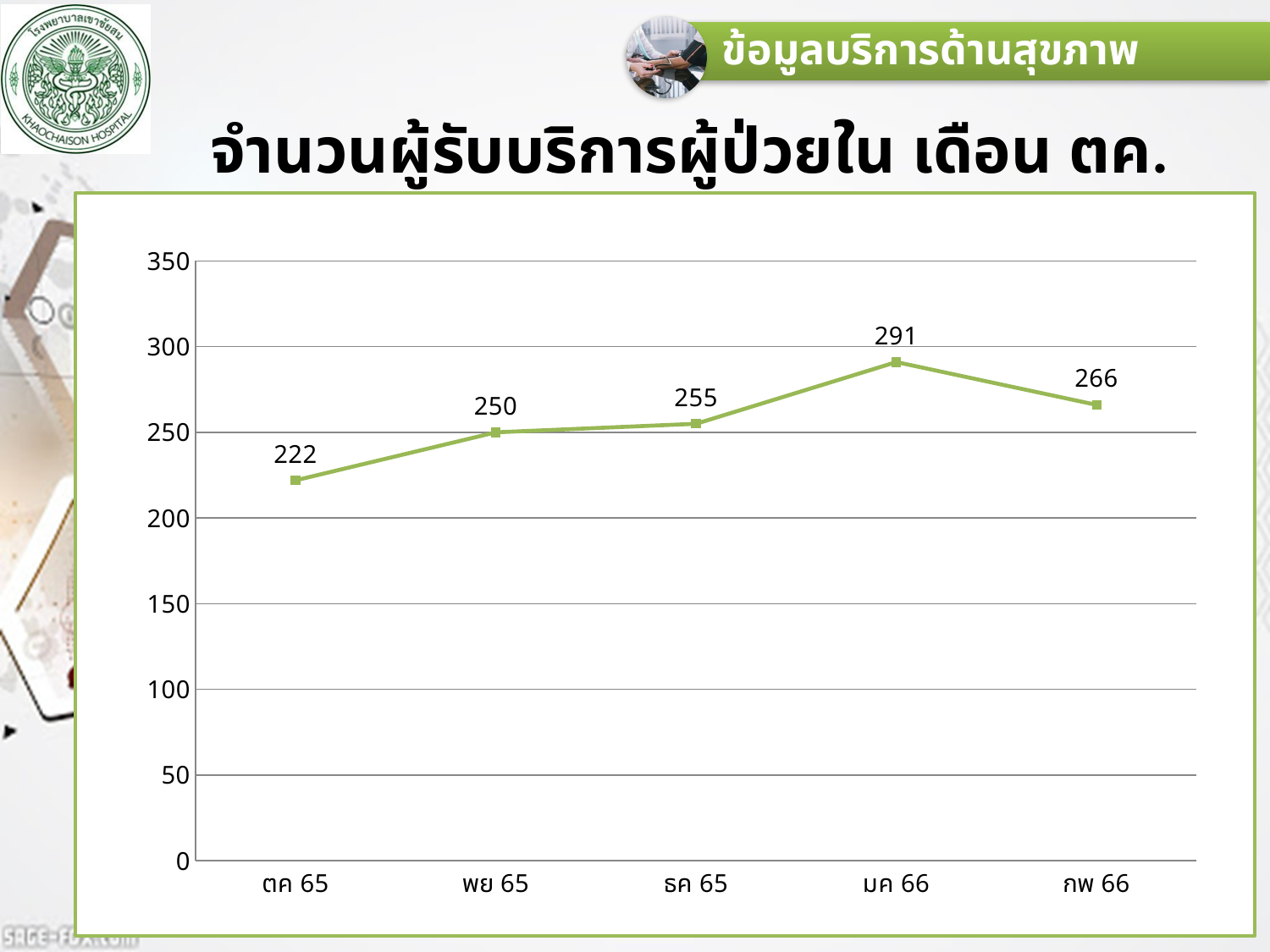
What is the value for มค 66? 291 Which month has the lowest value? ตค 65 Do the values rise or fall from ตค 65 to มค 66? rise Which month has the highest value? มค 66 What is the value for กพ 66? 266 How many months are plotted on the chart? 5 Which is larger, the value for พย 65 or the value for กพ 66? กพ 66 What is the difference between the values for มค 66 and กพ 66? 25 What is the value for ตค 65? 222 What is the difference between the values for ธค 65 and ตค 65? 33 What kind of chart is shown on the slide? line chart Is the value for ตค 65 greater or less than 250? less